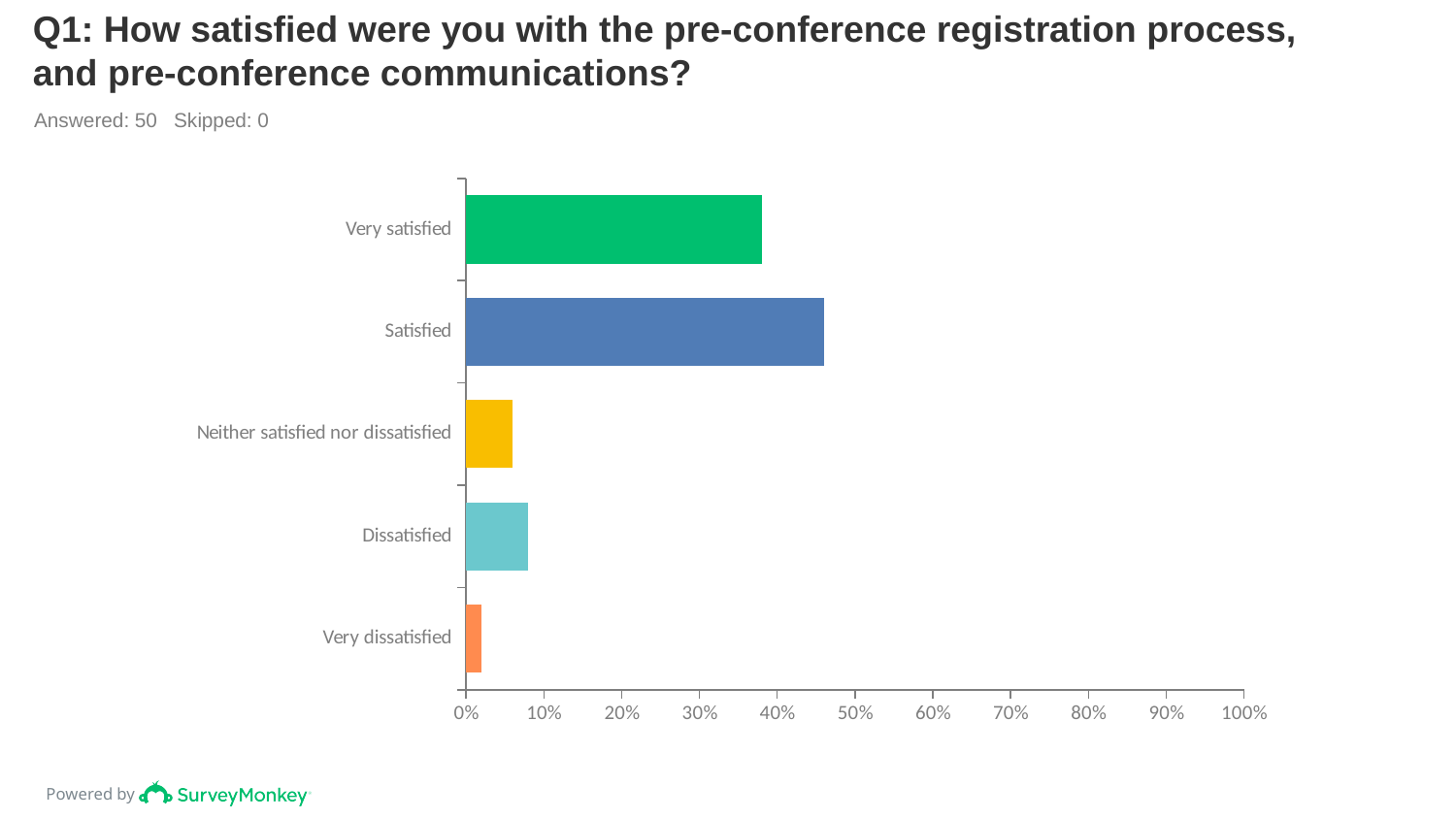
What kind of chart is shown on the slide? bar chart Which is larger, the value for Dissatisfied or the value for Very dissatisfied? Dissatisfied Which category has the lowest value? Very dissatisfied Is the value for Neither satisfied nor dissatisfied greater or less than 10%? less Is the value for Very satisfied greater or less than 30%? greater How many respondents answered this question according to the slide? 50 What is the maximum value shown on the horizontal axis? 100% How many categories are shown in the chart? 5 Is the value for Satisfied greater or less than 40%? greater Which is larger, the value for Very satisfied or the value for Satisfied? Satisfied Which category has the highest value? Satisfied